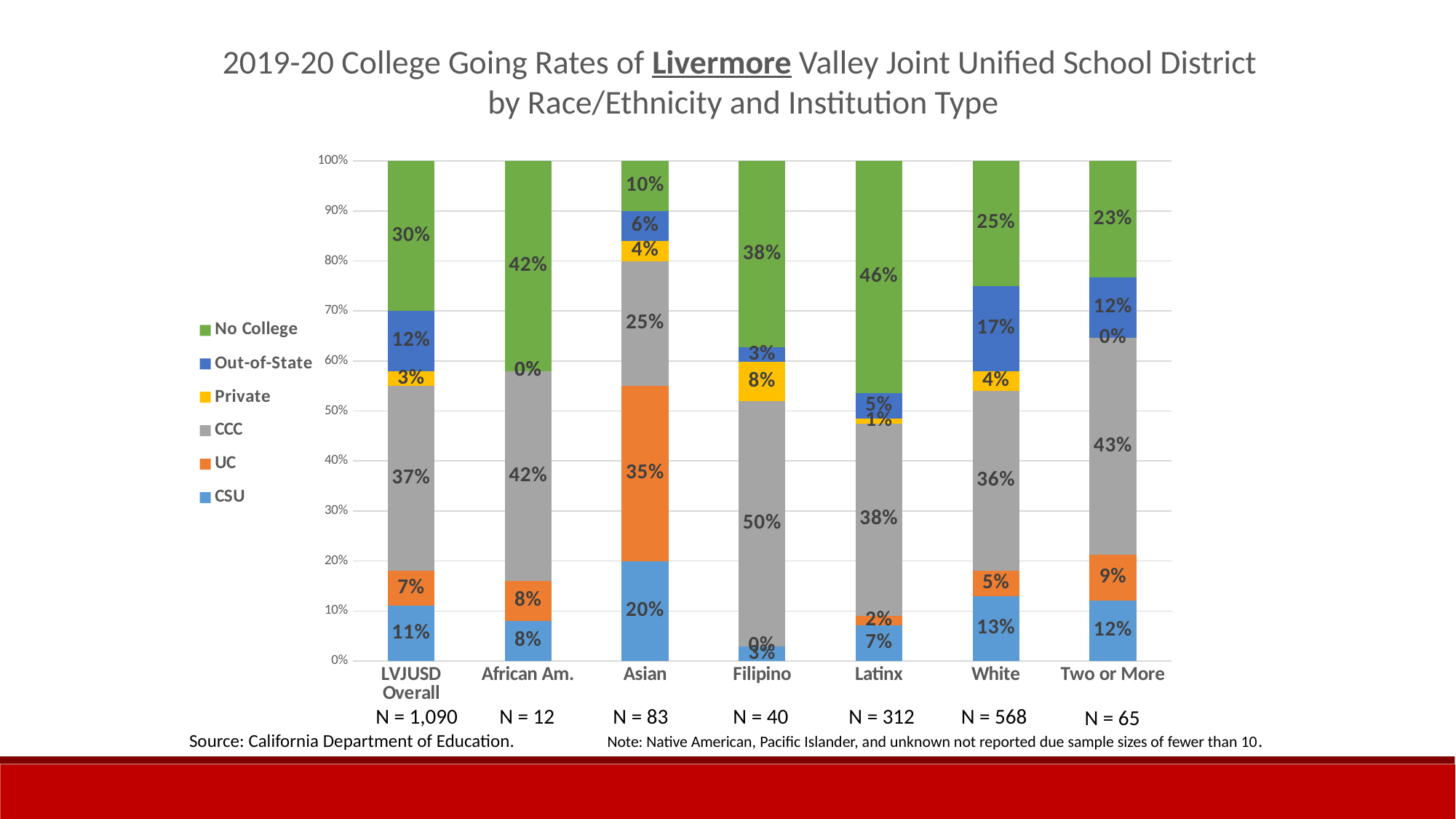
How many series does the legend list? 6 What is the difference in percentage points between the CCC share for Filipino students (50%) and for White students (36%)? 14 percentage points Which group has the highest No College percentage? Latinx What is the Private percentage for Filipino students? 8% What is the UC percentage for Asian students? 35% Which group has the lowest No College percentage? Asian What kind of chart is shown on the slide? Stacked bar chart How many race/ethnicity groups (bars) are shown on the x axis? 7 Which group has the highest CSU percentage? Asian What is the No College percentage for Latinx students? 46% Which group has a larger Out-of-State percentage, White or Two or More? White What is the CCC percentage for the Two or More group? 43%